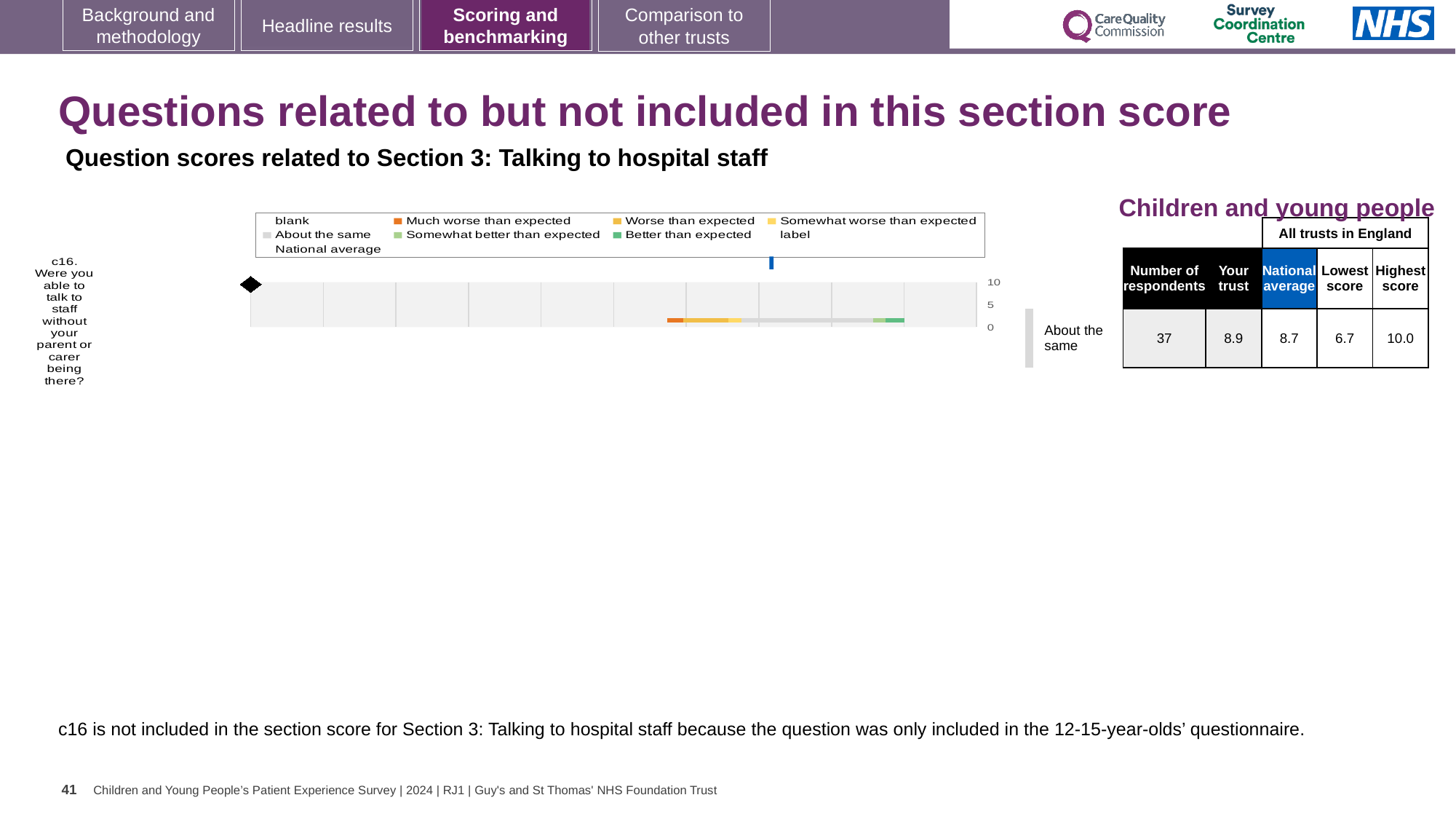
In the table beside the chart, what is the 'Your trust' score for c16? 8.9 Which benchmark category is shown next to the chart for c16? About the same How many entries does the chart legend list? 9 What kind of chart is shown on the slide? bar chart In the table beside the chart, which is larger for c16: the 'Your trust' score or the national average? Your trust In the table beside the chart, what is the highest score across all trusts in England for c16? 10.0 Which question is plotted in the chart? c16. Were you able to talk to staff without your parent or carer being there? In the table beside the chart, what is the number of respondents for c16? 37 In the table beside the chart, what is the national average score for c16? 8.7 What is the highest value shown on the chart's axis? 10 In the table beside the chart, what is the lowest score across all trusts in England for c16? 6.7 How many questions (categories) are plotted in the chart? 1